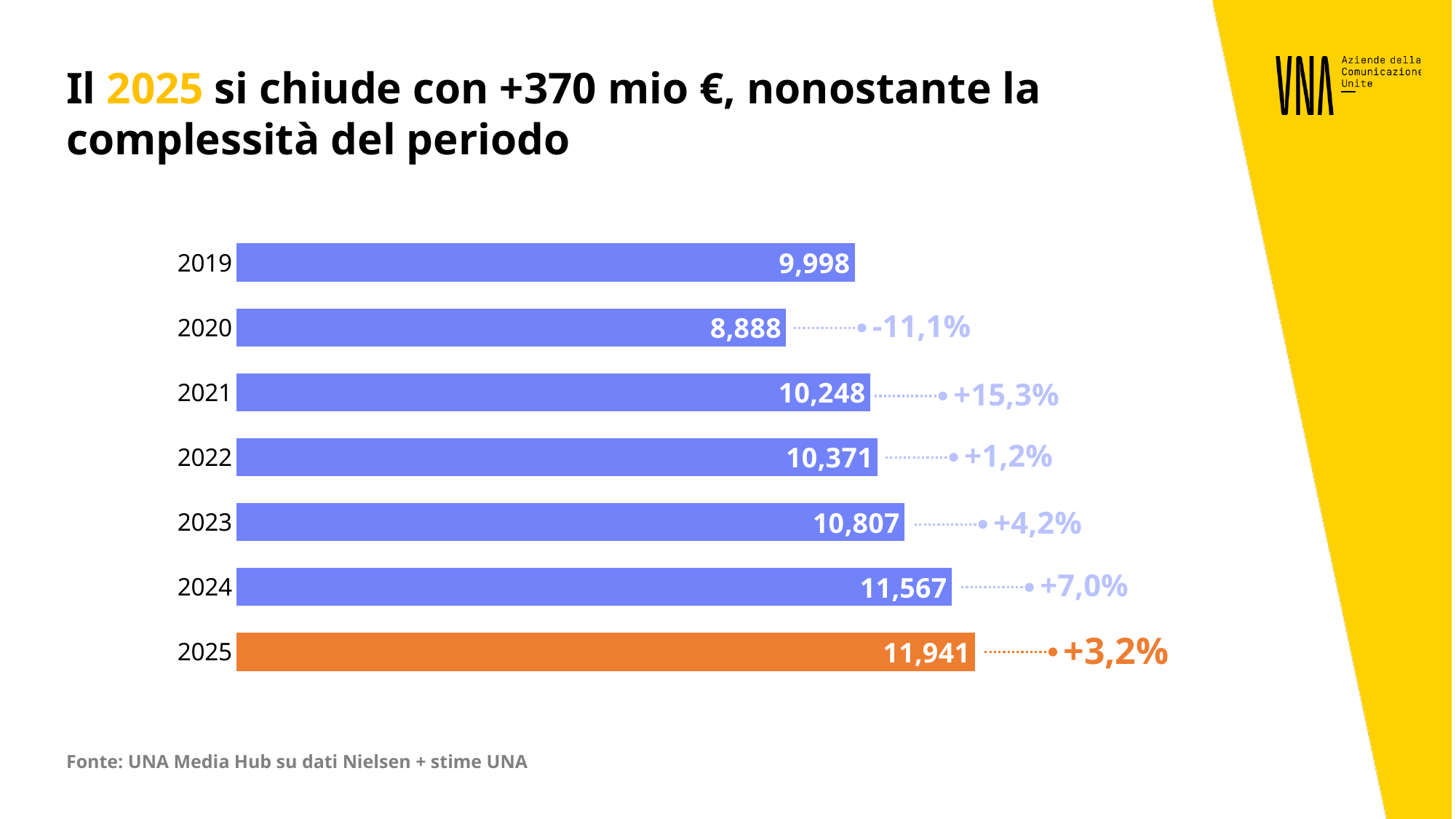
Which year's bar is coloured orange instead of blue? 2025 What is the difference between the values for 2021 and 2020? 1,360 What kind of chart is shown on the slide? Bar chart Which year has the lowest value? 2020 How many years are shown in the chart? 7 What is the value shown for 2025? 11,941 What is the difference between the values for 2025 and 2024? 374 What percentage change is shown next to the 2025 bar? +3,2% Which is larger, the value for 2019 or the value for 2022? 2022 What is the value shown for 2020? 8,888 Which year has the highest value? 2025 What percentage change is shown next to the 2021 bar? +15,3%